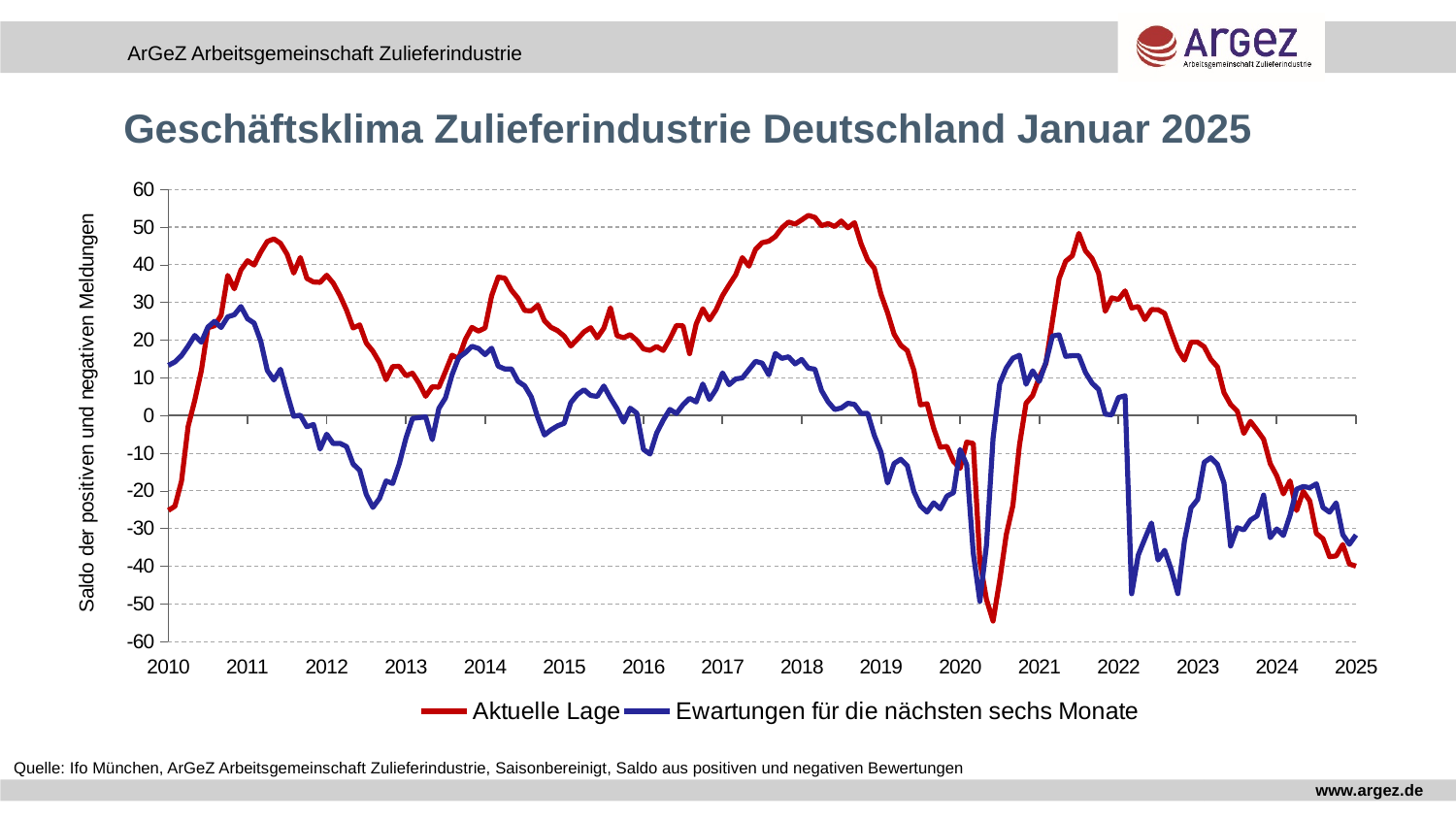
Is the peak value of 'Aktuelle Lage' around 2018 greater or less than 40? greater Is the value of 'Aktuelle Lage' at the end of the series in early 2025 greater or less than -30? less Does the 'Aktuelle Lage' series rise or fall between mid-2021 and 2025? fall Is the value of 'Aktuelle Lage' at the start of 2010 greater or less than -10? less Does the 'Aktuelle Lage' series rise or fall between the start of 2010 and the start of 2011? rise In 2018, which series has the higher values, 'Aktuelle Lage' or 'Ewartungen für die nächsten sechs Monate'? Aktuelle Lage How many series does the legend list? 2 What is the title of the chart? Geschäftsklima Zulieferindustrie Deutschland Januar 2025 Which colour is used for the 'Aktuelle Lage' series? red What kind of chart is shown on the slide? line chart